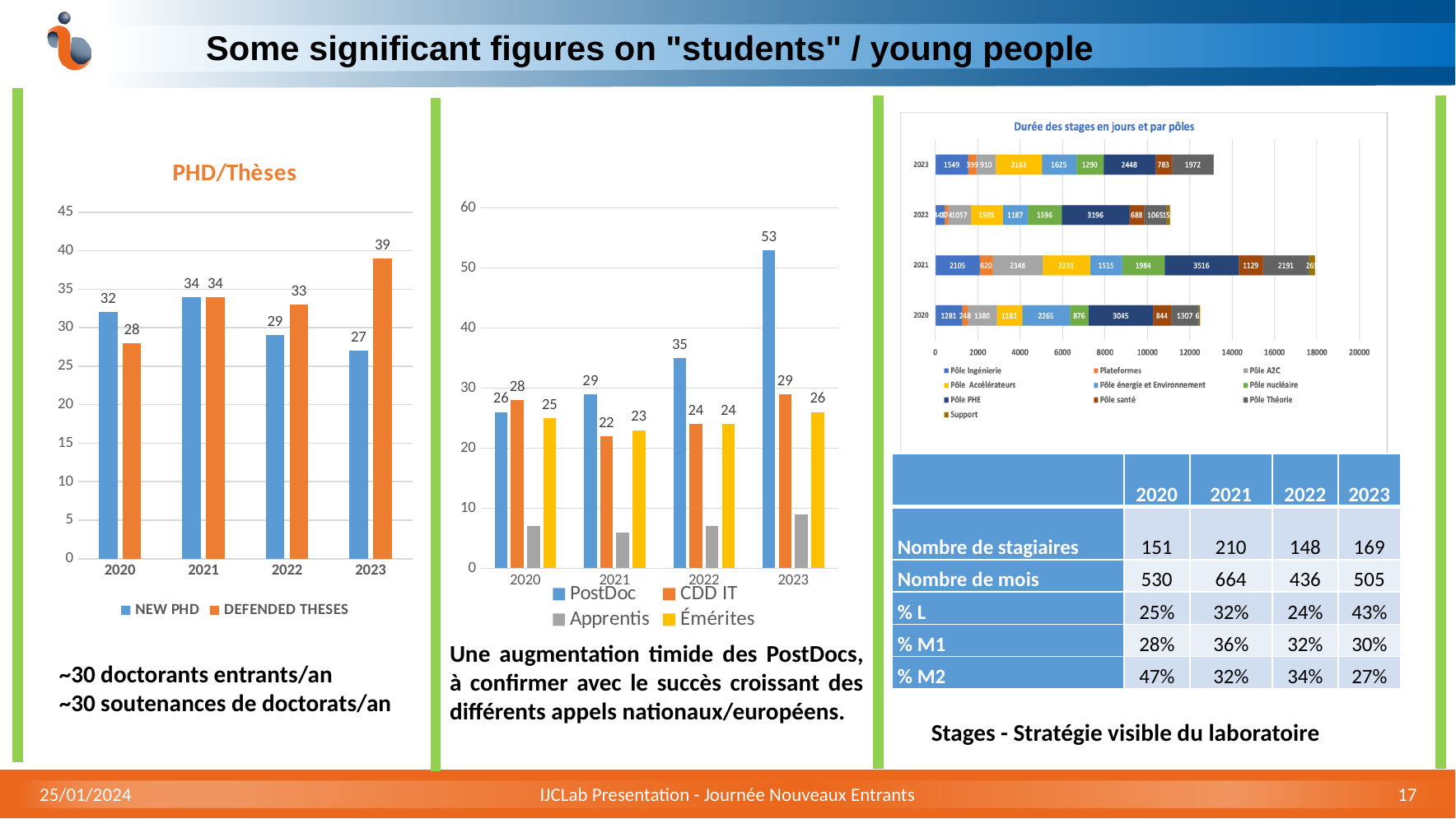
In the PHD/Thèses chart, what is the value for DEFENDED THESES in 2023? 39 In the middle chart, how many series does the legend list? 4 In the chart titled 'Durée des stages en jours et par pôles', how many series does the legend list? 10 In the middle chart, what is the value for PostDoc in 2023? 53 In the middle chart, what is the value for CDD IT in 2021? 22 In the PHD/Thèses chart, what is the difference between DEFENDED THESES and NEW PHD in 2023? 12 In the PHD/Thèses chart, which year has the highest number of DEFENDED THESES? 2023 In the middle chart, which is larger in 2022: PostDoc or Émérites? PostDoc In the PHD/Thèses chart, what is the value for NEW PHD in 2020? 32 In the PHD/Thèses chart, which year has the lowest number of NEW PHD? 2023 In the PHD/Thèses chart, do the NEW PHD values rise or fall from 2021 to 2023? fall